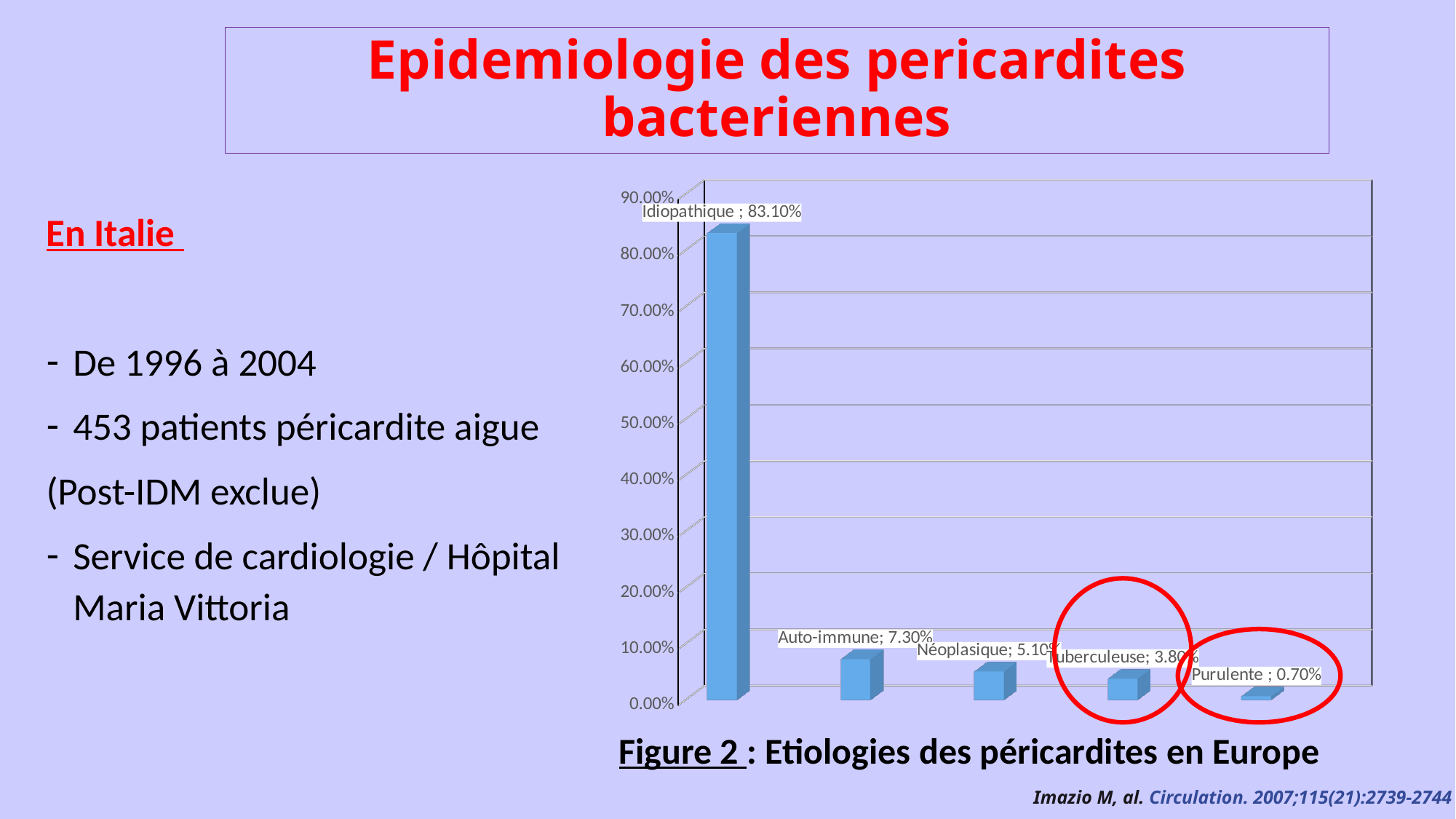
Which category has the highest value? Idiopathique Which category has the lowest value? Purulente What is the value for Idiopathique? 83.10% What is the value for Tuberculeuse? 3.80% How many categories are shown in the chart? 5 What is the value for Néoplasique? 5.10% What kind of chart is shown on the slide? Bar chart What is the difference between the values for Auto-immune and Néoplasique? 2.20% What is the value for Auto-immune? 7.30% Which is larger, the value for Tuberculeuse or the value for Purulente? Tuberculeuse Do the values rise or fall from left to right along the x axis? Fall What is the value for Purulente? 0.70%